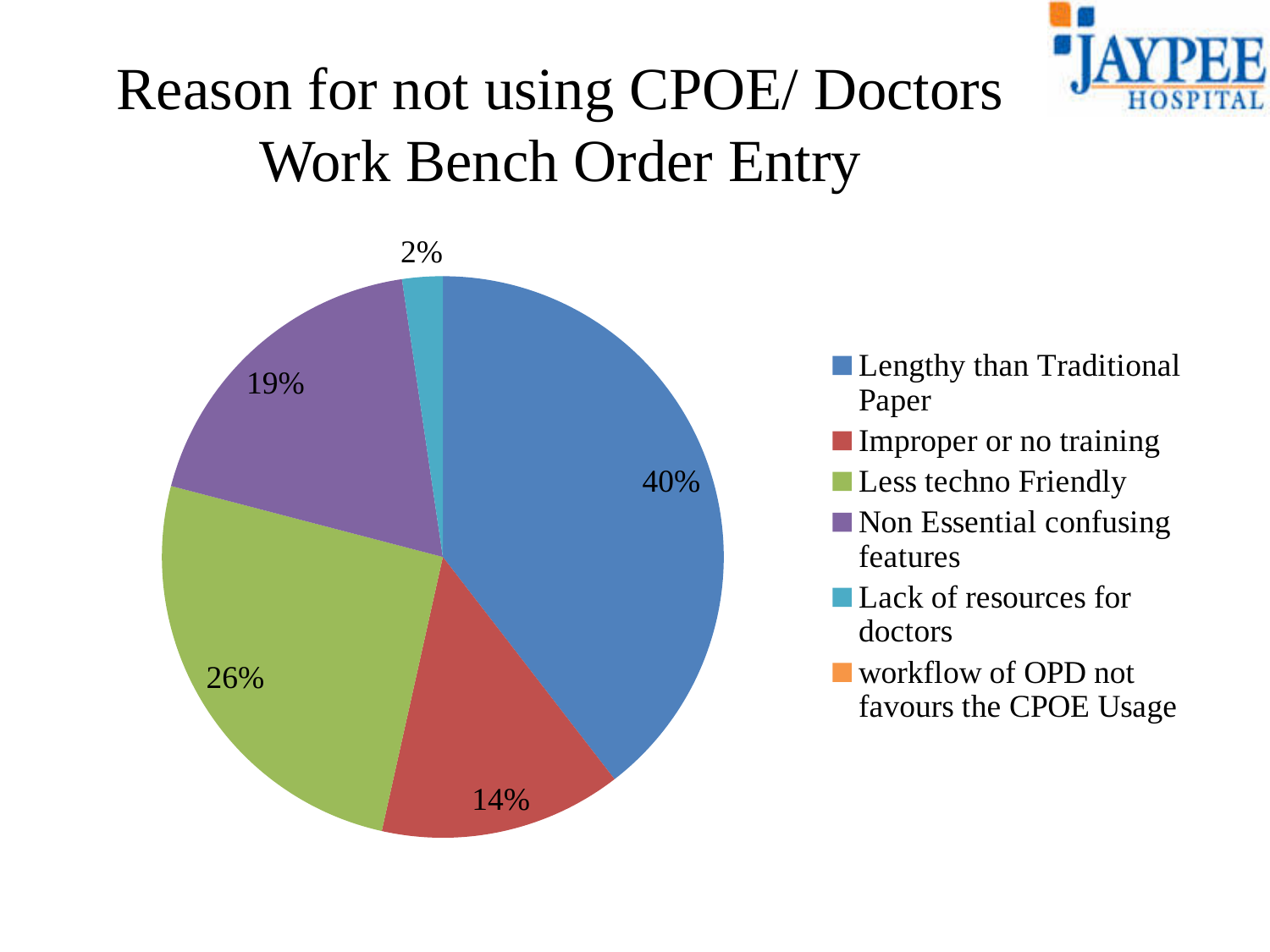
What percentage is shown for 'Improper or no training'? 14% What is the difference in percentage points between 'Lengthy than Traditional Paper' and 'Less techno Friendly'? 14 Which reason has the largest share of the pie? Lengthy than Traditional Paper What share of the pie is labelled for 'Lengthy than Traditional Paper'? 40% Which is larger: the share for 'Less techno Friendly' or the share for 'Non Essential confusing features'? Less techno Friendly What percentage is shown for 'Lack of resources for doctors'? 2% What percentage is shown for 'Less techno Friendly'? 26% How many entries does the legend list? 6 Which labelled slice has the smallest share of the pie? Lack of resources for doctors What kind of chart is shown on the slide? pie chart What percentage is shown for 'Non Essential confusing features'? 19% What colour is the slice for 'Improper or no training'? red